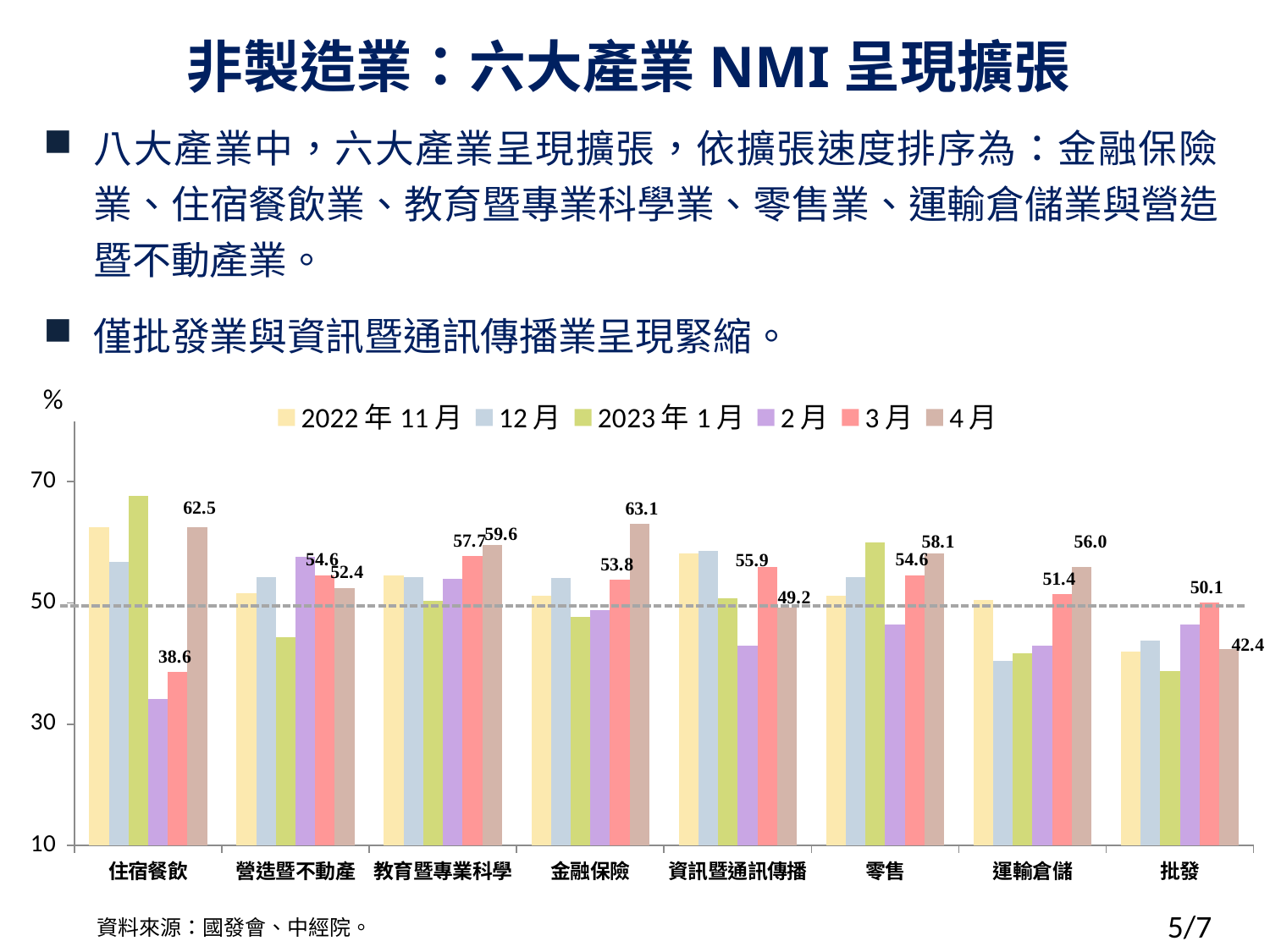
Which is larger for 資訊暨通訊傳播: the 3月 value or the 4月 value? 3月 Which industry has the lowest 4月 value? 批發 What is the 4月 value for 金融保險? 63.1 How many series does the legend list? 6 What is the 3月 value for 住宿餐飲? 38.6 What is the 4月 value for 批發? 42.4 What kind of chart is shown on the slide? bar chart Which industry has the highest 4月 value? 金融保險 Is the 2023年1月 value for 住宿餐飲 greater or less than 50? greater How many industries are shown on the x axis? 8 What is the difference between the 4月 and 3月 values for 住宿餐飲? 23.9 Is the 2月 value for 批發 greater or less than 50? less